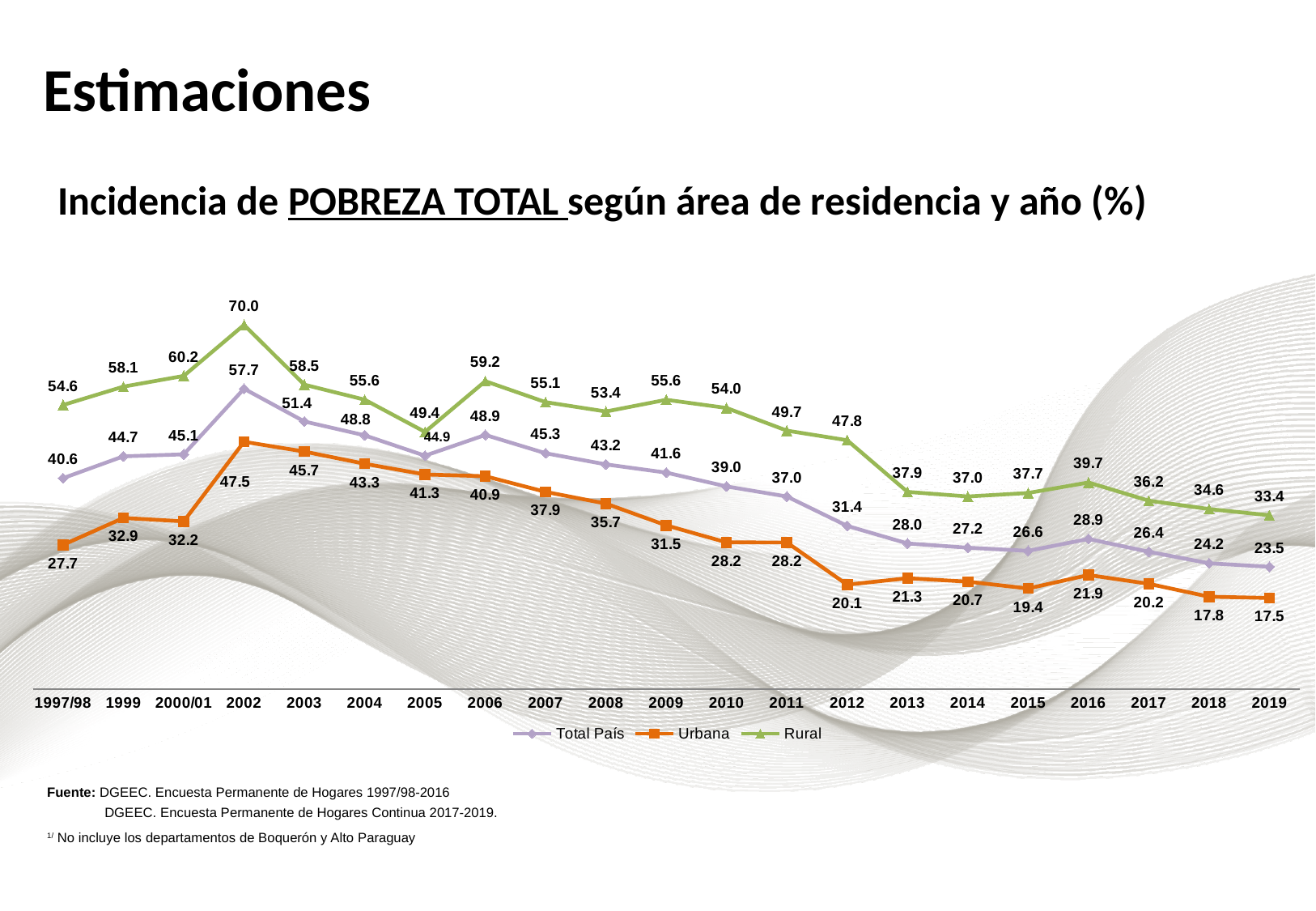
What type of chart is shown on the slide? line chart What is the Total País value for 2012? 31.4 Does the Total País series generally rise or fall from 2002 to 2019? fall What is the Rural value for 2002? 70.0 Which is larger in 2005: the Total País value or the Urbana value? Total País What is the Urbana value for 2019? 17.5 In which year does the Rural series reach its highest value? 2002 Which series is shown in green in the legend? Rural In which year is the Urbana series at its lowest value? 2019 How many series does the legend list? 3 What is the difference between the Rural and Urbana values in 2019? 15.9 How many years (x-axis categories) are plotted on the chart? 21